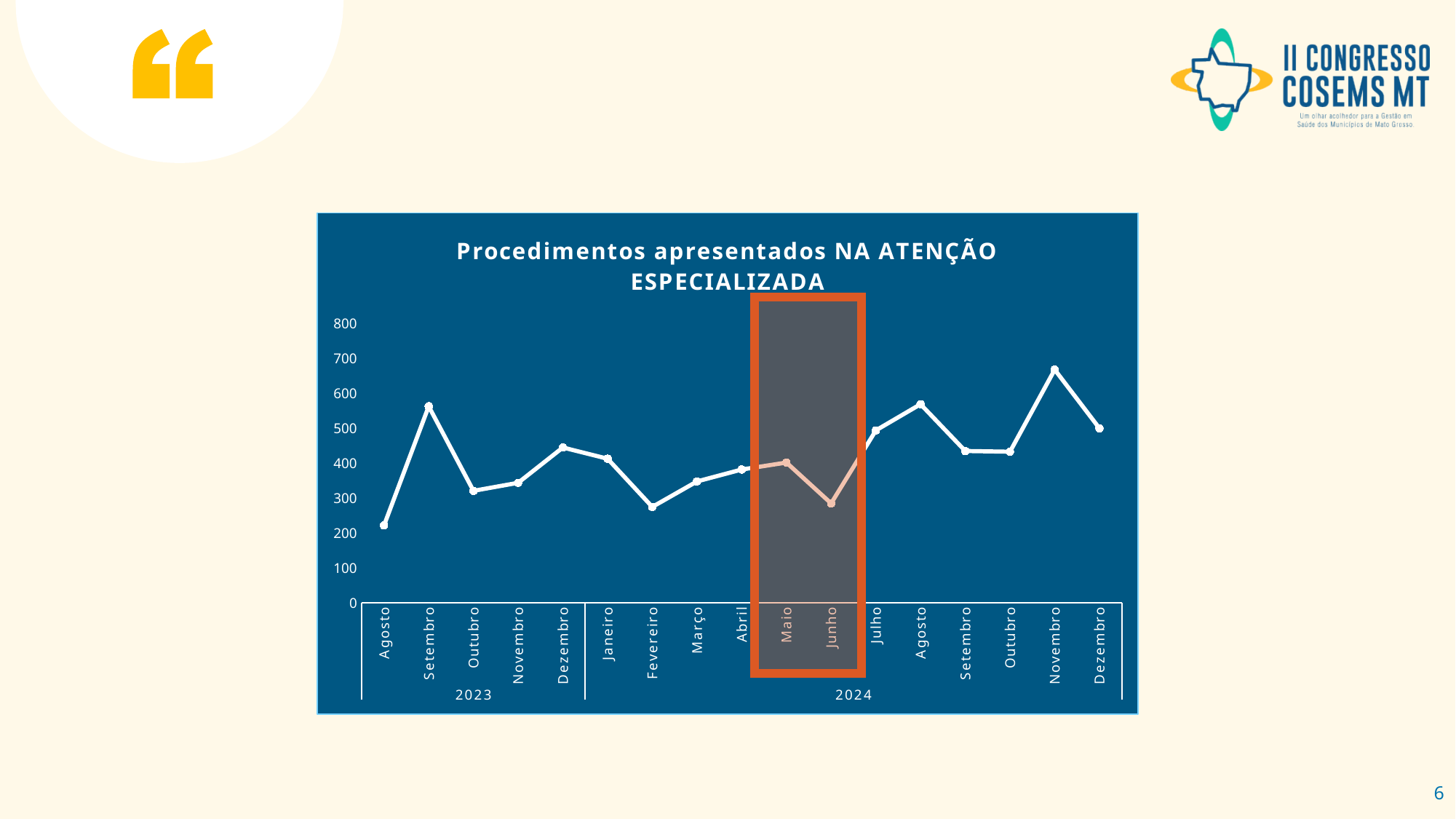
Which two months are highlighted with an orange box on the chart? Maio and Junho 2024 Is the value for Setembro 2023 greater or less than 500? greater Which month has the highest value on the chart? Novembro 2024 Does the value rise or fall from Maio 2024 to Junho 2024? fall What kind of chart is shown on the slide? line chart Which month has the lowest value on the chart? Agosto 2023 How many monthly data points are plotted on the chart? 17 What is the title of the chart? Procedimentos apresentados NA ATENÇÃO ESPECIALIZADA Which is larger, the value for Setembro 2023 or Outubro 2023? Setembro 2023 Is the value for Agosto 2023 greater or less than 300? less Is the value for Novembro 2024 greater or less than 600? greater